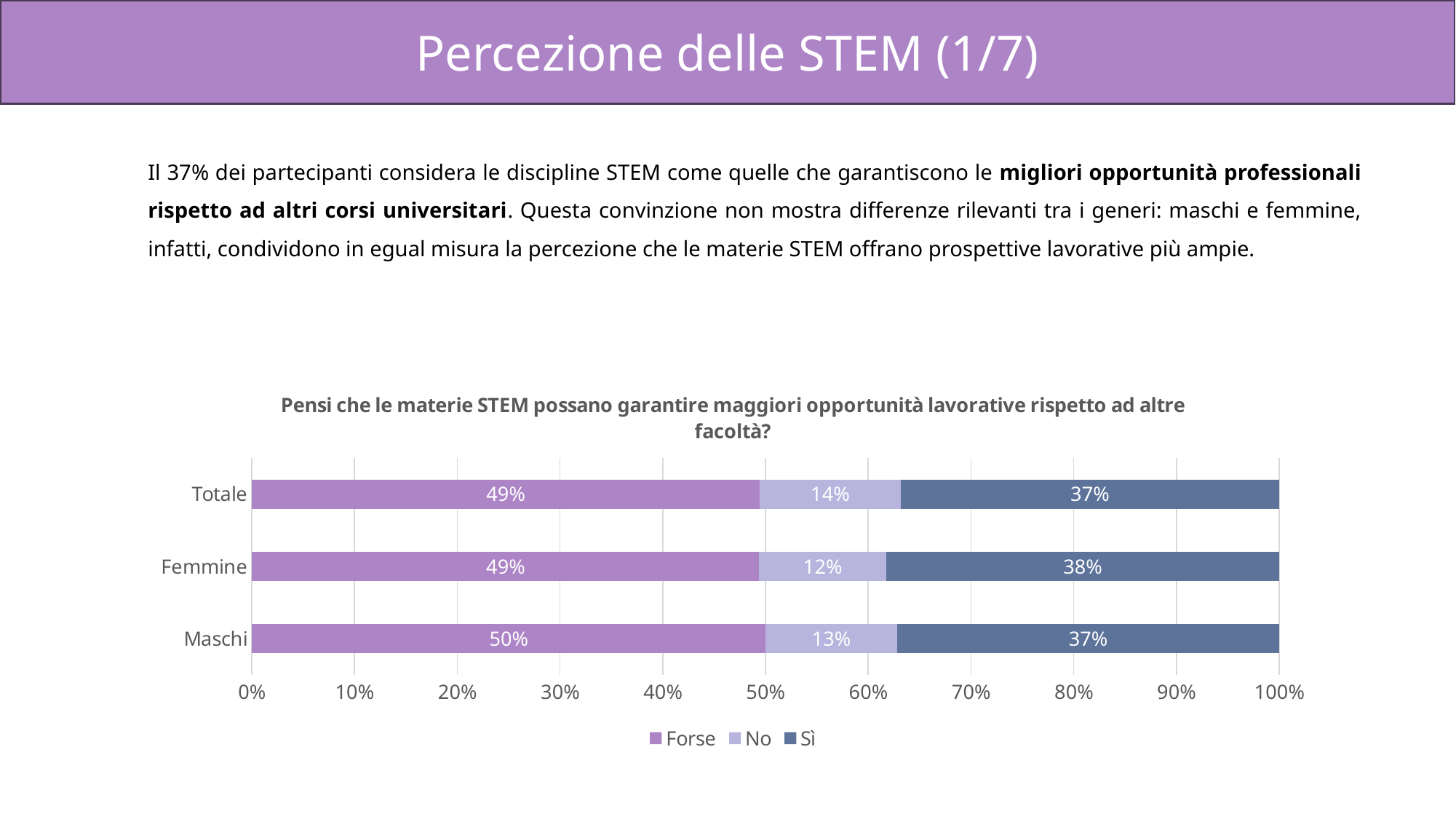
What percentage of Femmine answered "Sì"? 38% What is the difference between the "Forse" and "Sì" values for Totale? 12% What kind of chart is shown? Stacked bar chart How many series does the legend list? 3 What percentage of Totale answered "Forse"? 49% How many categories are shown on the y axis? 3 What percentage of Maschi answered "No"? 13% Which category has the lowest "No" value? Femmine Which is larger: the "Sì" value for Femmine or the "Sì" value for Maschi? Femmine What is the total of the stacked bar for Femmine? 99% Which category has the highest "No" value? Totale What percentage of Maschi answered "Forse"? 50%